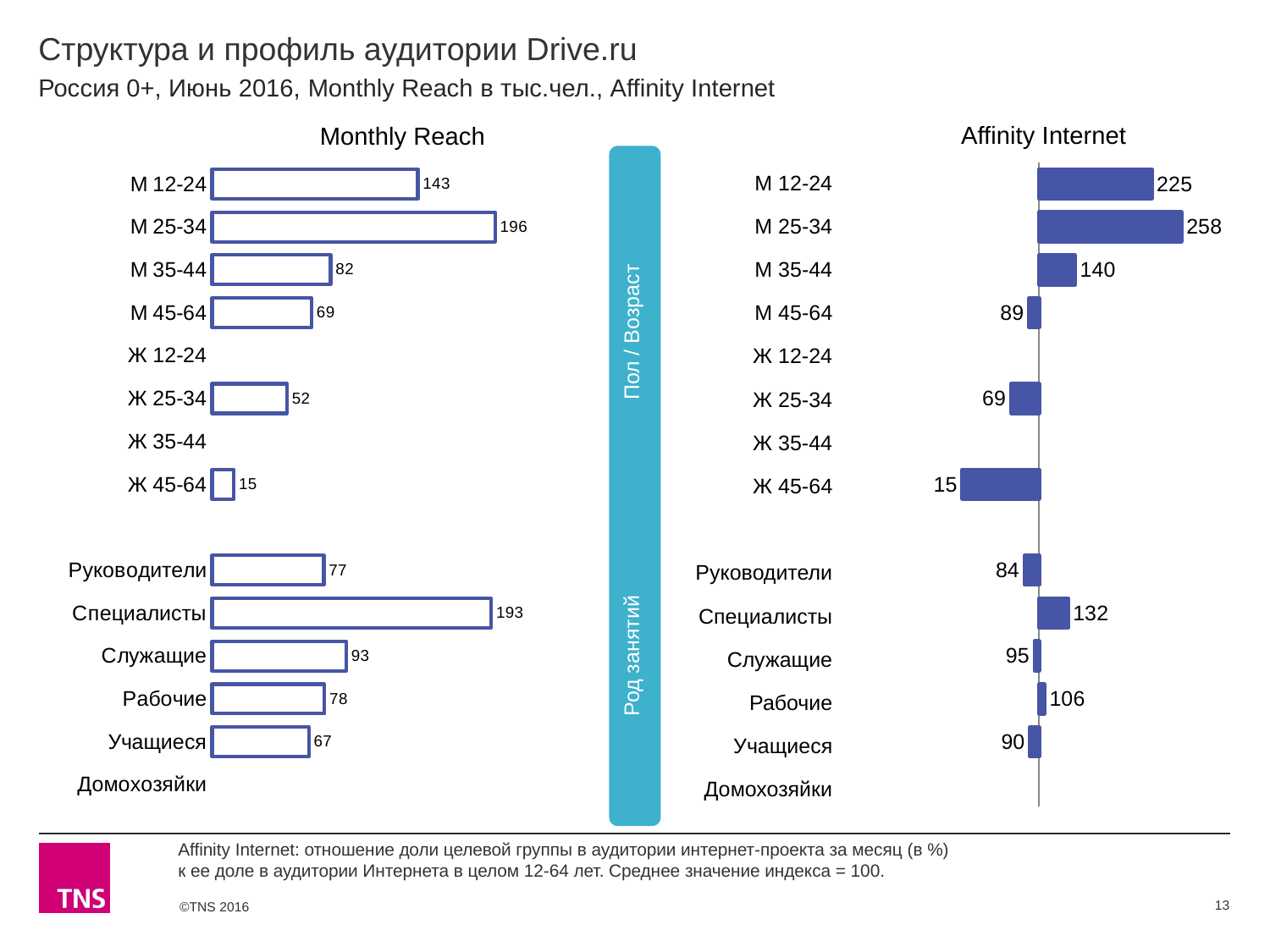
In the Affinity Internet chart, what is the difference between М 12-24 and Специалисты? 93 In the Monthly Reach chart, which is larger: Служащие or Рабочие? Служащие In the Monthly Reach chart, what is the difference between М 12-24 and М 35-44? 61 In the Affinity Internet chart, what is the value for М 35-44? 140 In the Monthly Reach chart, what is the value for М 25-34? 196 What type of chart is the Monthly Reach chart? Bar chart In the Affinity Internet chart, what is the value for Рабочие? 106 In the Affinity Internet chart, which category has the highest value? М 25-34 In the Monthly Reach chart, which labelled category has the lowest value? Ж 45-64 In the Affinity Internet chart, which is larger: Руководители or Учащиеся? Учащиеся In the Monthly Reach chart, what is the value for Специалисты? 193 What is the title of the chart on the right side of the slide? Affinity Internet